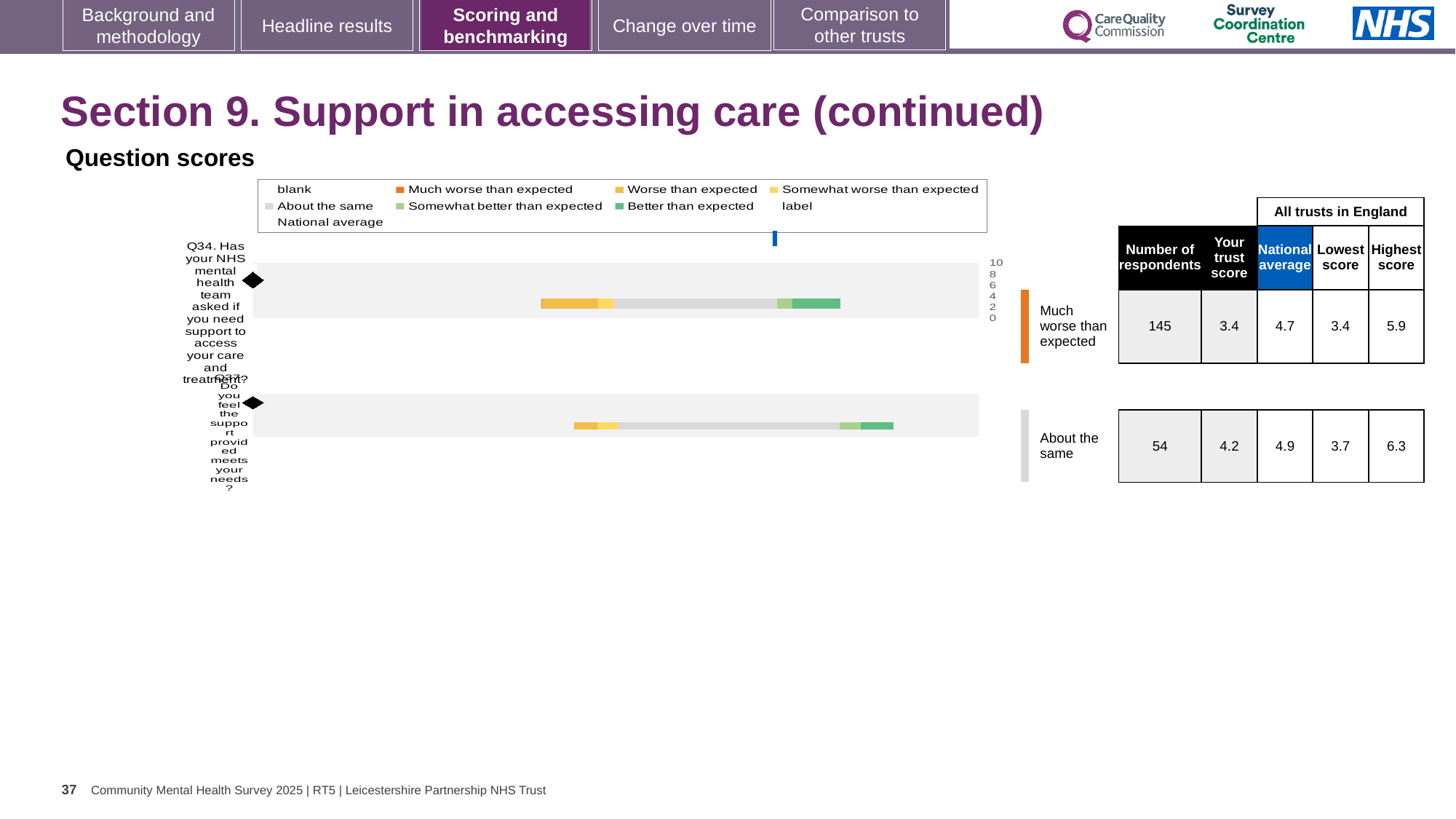
What is the difference in the number of respondents between Q34 and Q37? 91 What is the trust score for Q34 in the question scores chart? 3.4 What is the highest score across all trusts in England for Q37? 6.3 What is the difference between the national average and the trust score for Q34? 1.3 What is the number of respondents for Q34 in the question scores chart? 145 What kind of chart is used to show the question scores on this slide? Bar chart What is the national average for Q37 in the question scores chart? 4.9 Which benchmark category is Q37 placed in? About the same Which benchmark category is Q34 placed in? Much worse than expected For Q34, is the trust score or the national average higher? National average Which question has more respondents, Q34 or Q37? Q34 How many questions are plotted in the question scores chart? 2